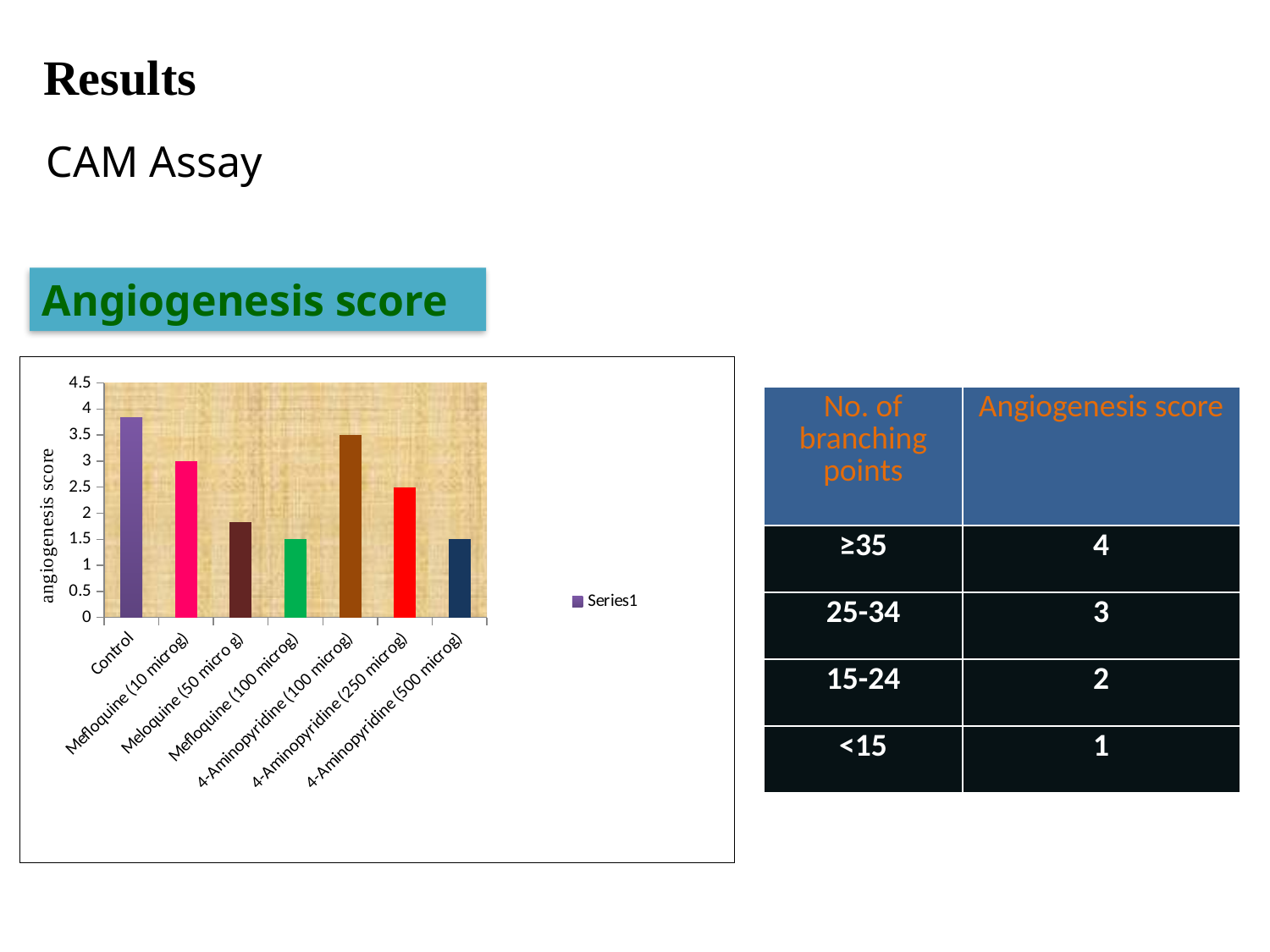
What is the angiogenesis score for Mefloquine (10 microg)? 3 What is the angiogenesis score for 4-Aminopyridine (250 microg)? 2.5 Which is larger, the value for Control or the value for 4-Aminopyridine (100 microg)? Control Which category has the highest angiogenesis score in the chart? Control Is the value for Control greater or less than 3.5? greater What kind of chart is shown on the slide? bar chart Is the value for Meloquine (50 micro g) greater or less than 2? less What is the angiogenesis score for 4-Aminopyridine (100 microg)? 3.5 How many categories are plotted on the x axis of the chart? 7 What is the label on the chart's vertical axis? angiogenesis score What is the difference between the values for 4-Aminopyridine (100 microg) and 4-Aminopyridine (250 microg)? 1 How many series does the chart's legend list? 1